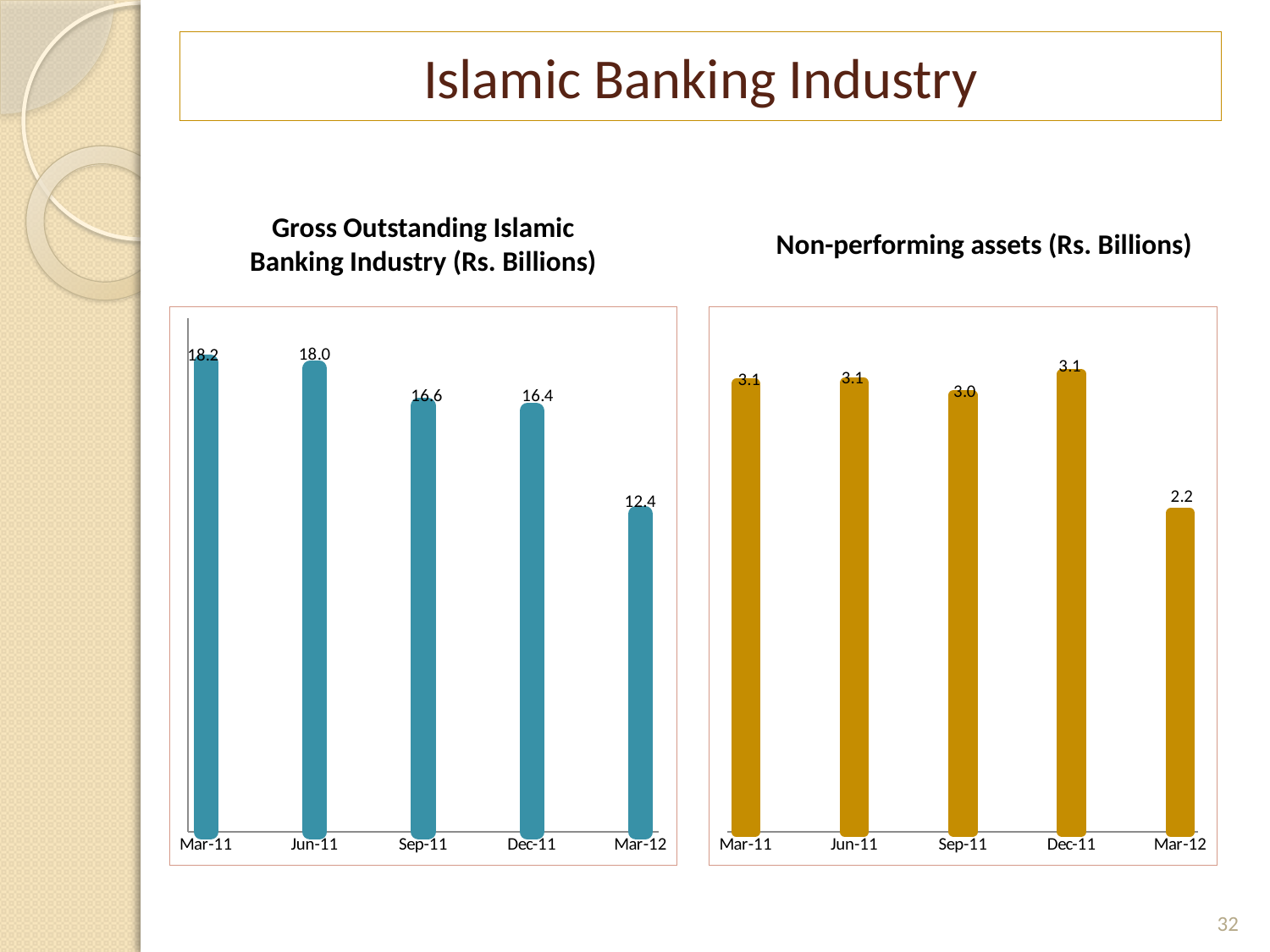
In the 'Non-performing assets (Rs. Billions)' chart, what is the difference between the Dec-11 and Mar-12 values? 0.9 What kind of chart is the 'Gross Outstanding Islamic Banking Industry (Rs. Billions)' chart? bar chart In the 'Gross Outstanding Islamic Banking Industry (Rs. Billions)' chart, which period has the highest value? Mar-11 In the 'Gross Outstanding Islamic Banking Industry (Rs. Billions)' chart, what is the value for Mar-11? 18.2 In the 'Non-performing assets (Rs. Billions)' chart, which period has the lowest value? Mar-12 In the 'Gross Outstanding Islamic Banking Industry (Rs. Billions)' chart, which period has the lowest value? Mar-12 How many periods are shown on the x axis of the 'Non-performing assets (Rs. Billions)' chart? 5 In the 'Gross Outstanding Islamic Banking Industry (Rs. Billions)' chart, do the values generally rise or fall from Mar-11 to Mar-12? fall In the 'Non-performing assets (Rs. Billions)' chart, what is the value for Mar-12? 2.2 In the 'Gross Outstanding Islamic Banking Industry (Rs. Billions)' chart, what is the value for Mar-12? 12.4 In the 'Gross Outstanding Islamic Banking Industry (Rs. Billions)' chart, what is the difference between the Jun-11 and Sep-11 values? 1.4 In the 'Non-performing assets (Rs. Billions)' chart, what is the value for Sep-11? 3.0